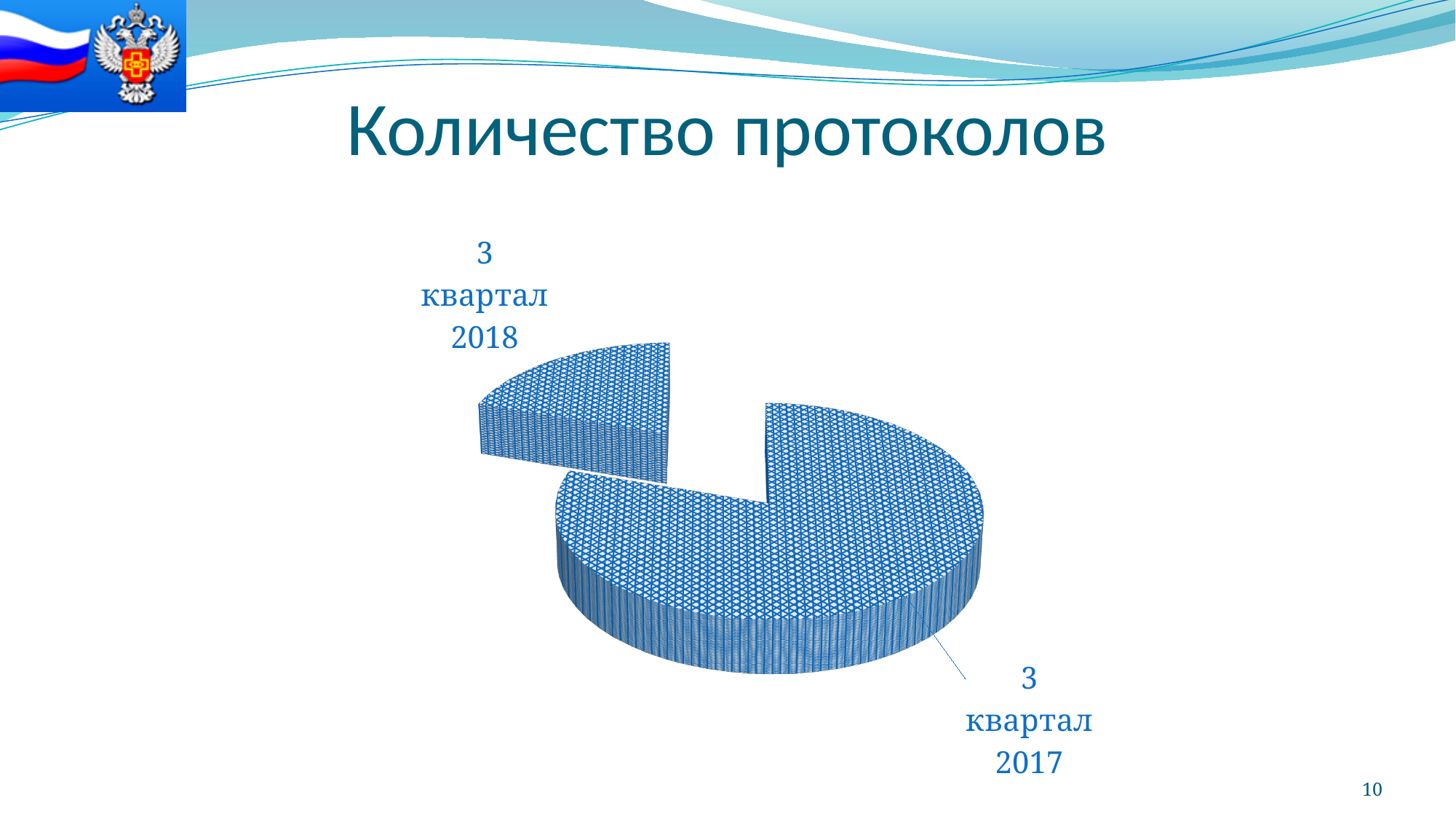
What kind of chart is shown on the slide? pie chart Which category has the largest slice of the pie? 3 квартал 2017 What is the title of the chart on the slide? Количество протоколов How many slices does the pie chart have? 2 Which category has the smallest slice of the pie? 3 квартал 2018 Which slice is larger, 3 квартал 2017 or 3 квартал 2018? 3 квартал 2017 Which slice of the pie is pulled out (exploded) from the rest? 3 квартал 2018